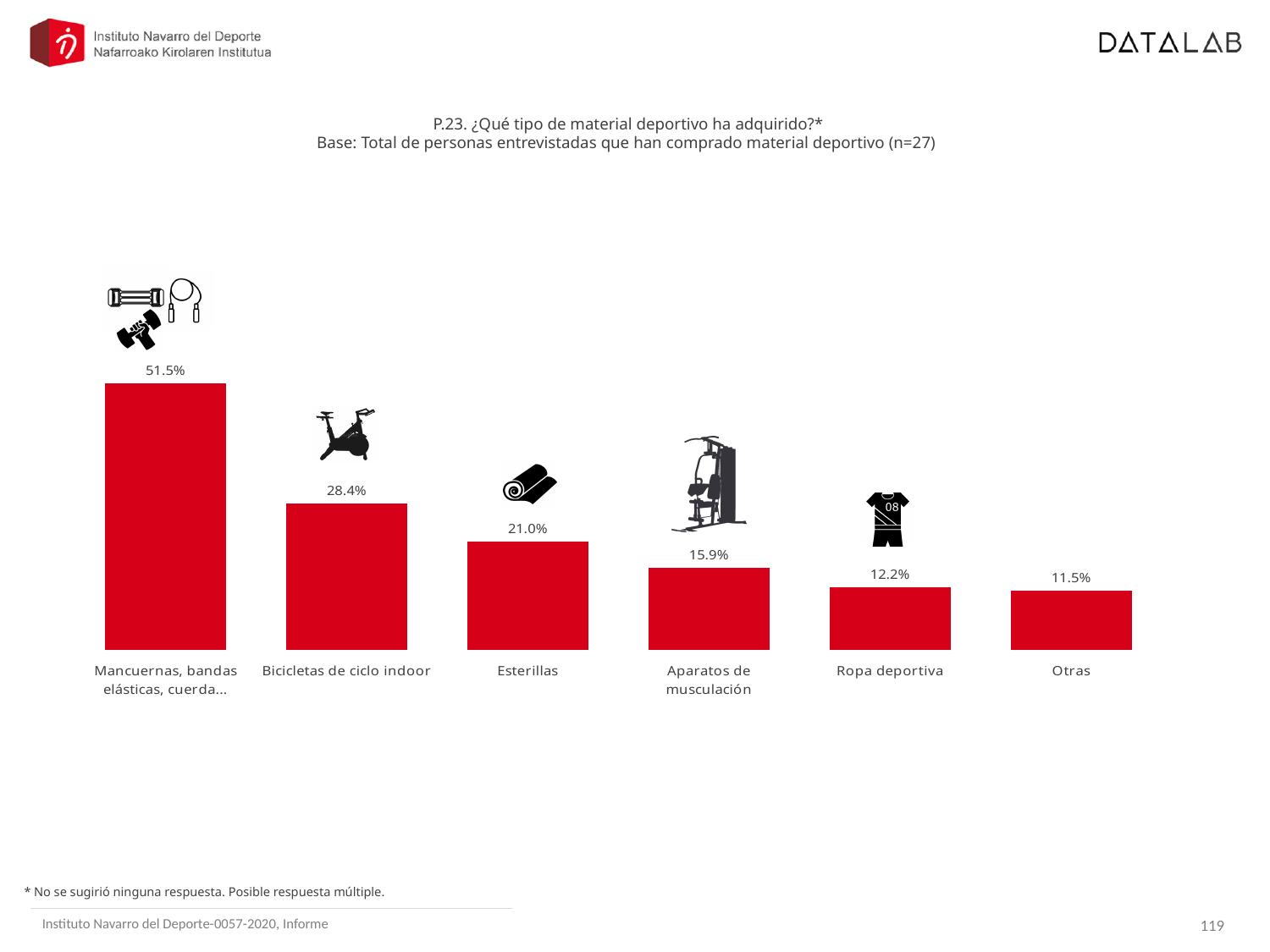
What is the difference between the values for 'Bicicletas de ciclo indoor' and 'Esterillas'? 7.4% Which is larger, the value for 'Aparatos de musculación' or the value for 'Ropa deportiva'? Aparatos de musculación Which category has the highest value? Mancuernas, bandas elásticas, cuerda... Which category has the lowest value? Otras How many categories are shown in the chart? 6 Do the values rise or fall from left to right across the categories? Fall What is the value shown for 'Bicicletas de ciclo indoor'? 28.4% What is the difference between the values for 'Aparatos de musculación' and 'Otras'? 4.4% What is the value shown for 'Ropa deportiva'? 12.2% What is the sample size (n) stated in the chart's base description? 27 What percentage of respondents acquired 'Esterillas'? 21.0% What kind of chart is shown on the slide? Bar chart